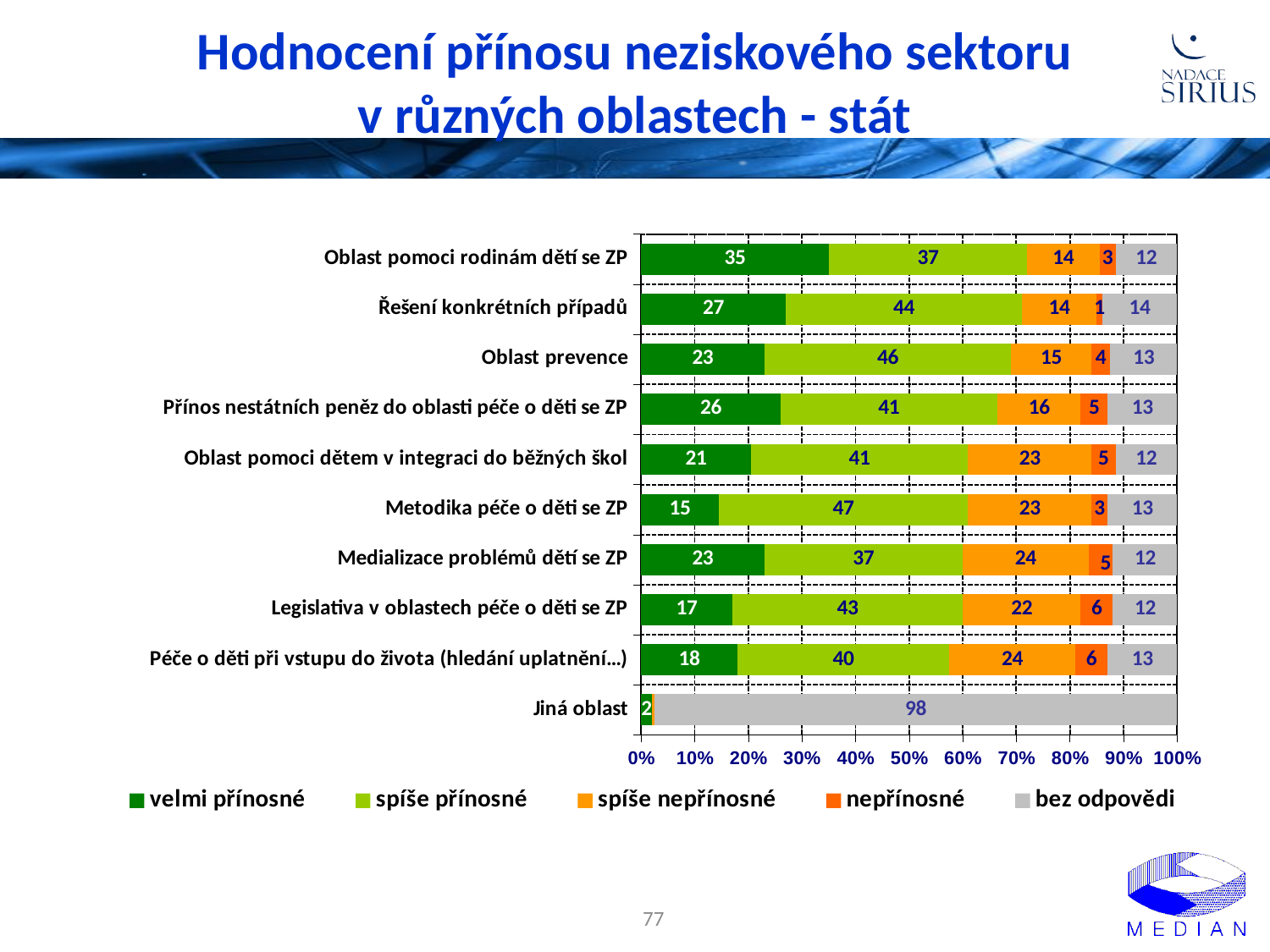
How many categories (areas) are plotted on the chart? 10 Which category has the lowest 'velmi přínosné' value? Jiná oblast What is the 'bez odpovědi' value for 'Jiná oblast'? 98 What is the 'spíše přínosné' value for 'Metodika péče o děti se ZP'? 47 What is the 'velmi přínosné' value for 'Oblast pomoci rodinám dětí se ZP'? 35 Which is larger: the 'spíše nepřínosné' value for 'Medializace problémů dětí se ZP' or for 'Oblast prevence'? Medializace problémů dětí se ZP How many series does the legend list? 5 Which category has the highest 'velmi přínosné' value? Oblast pomoci rodinám dětí se ZP What is the total of the stacked bar for 'Řešení konkrétních případů'? 100 What is the difference between the 'velmi přínosné' values for 'Oblast pomoci rodinám dětí se ZP' and 'Řešení konkrétních případů'? 8 What kind of chart is shown on the slide? stacked bar chart Which category has the highest 'spíše přínosné' value? Metodika péče o děti se ZP